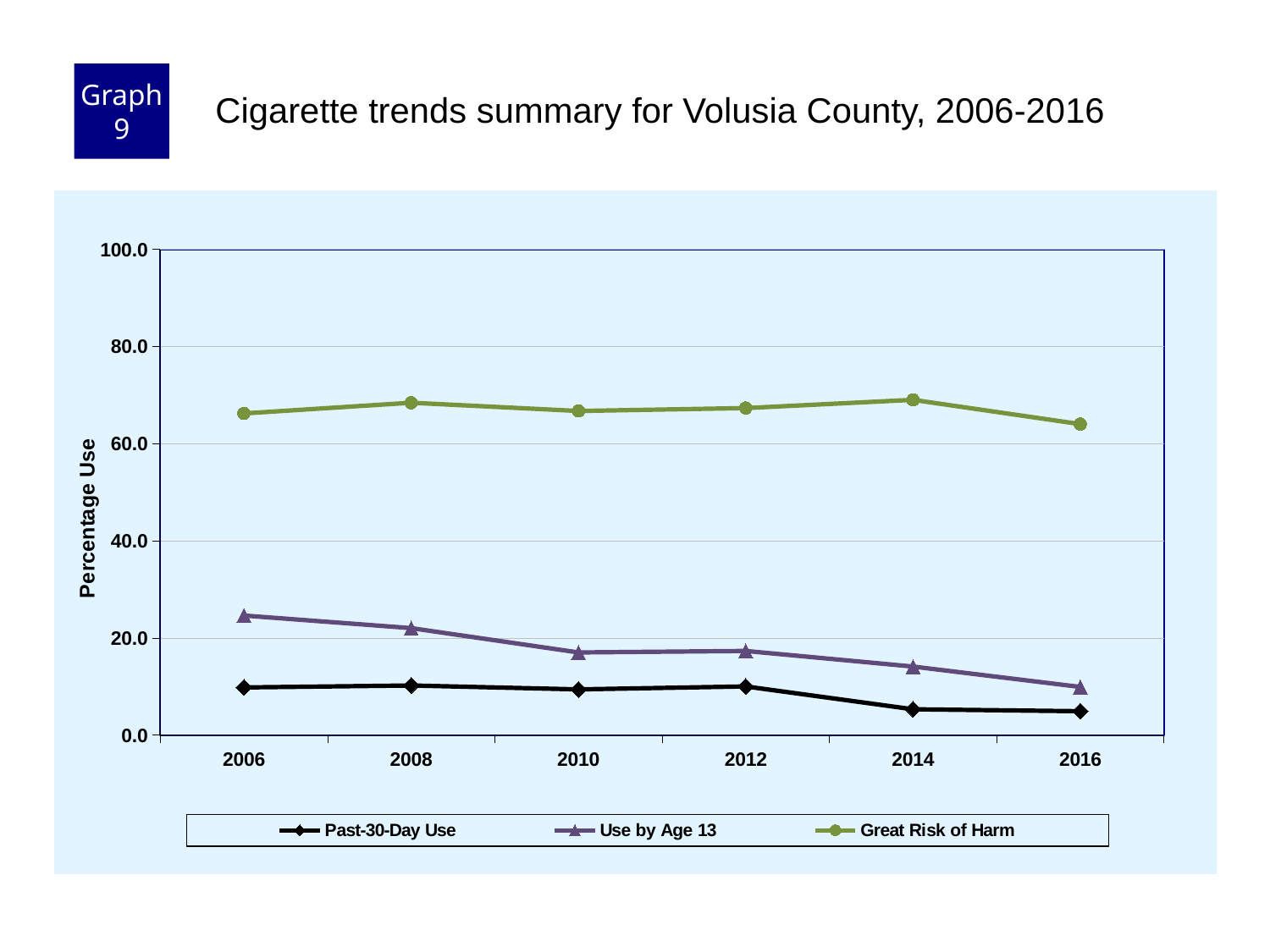
What is the label on the y axis? Percentage Use How many series does the legend list? 3 In which year is Use by Age 13 at its lowest? 2016 What kind of chart is shown on the slide? line chart Is the value for Great Risk of Harm in 2006 greater or less than 60.0? greater Which series has the highest values across all years? Great Risk of Harm Is the value for Past-30-Day Use in 2016 greater or less than 20.0? less Is the value for Use by Age 13 in 2006 greater or less than 20.0? greater Does the Past-30-Day Use line rise or fall overall from 2006 to 2016? fall How many years are plotted along the x axis? 6 In 2016, which is higher, Use by Age 13 or Past-30-Day Use? Use by Age 13 Does the Use by Age 13 line rise or fall from 2006 to 2016? fall